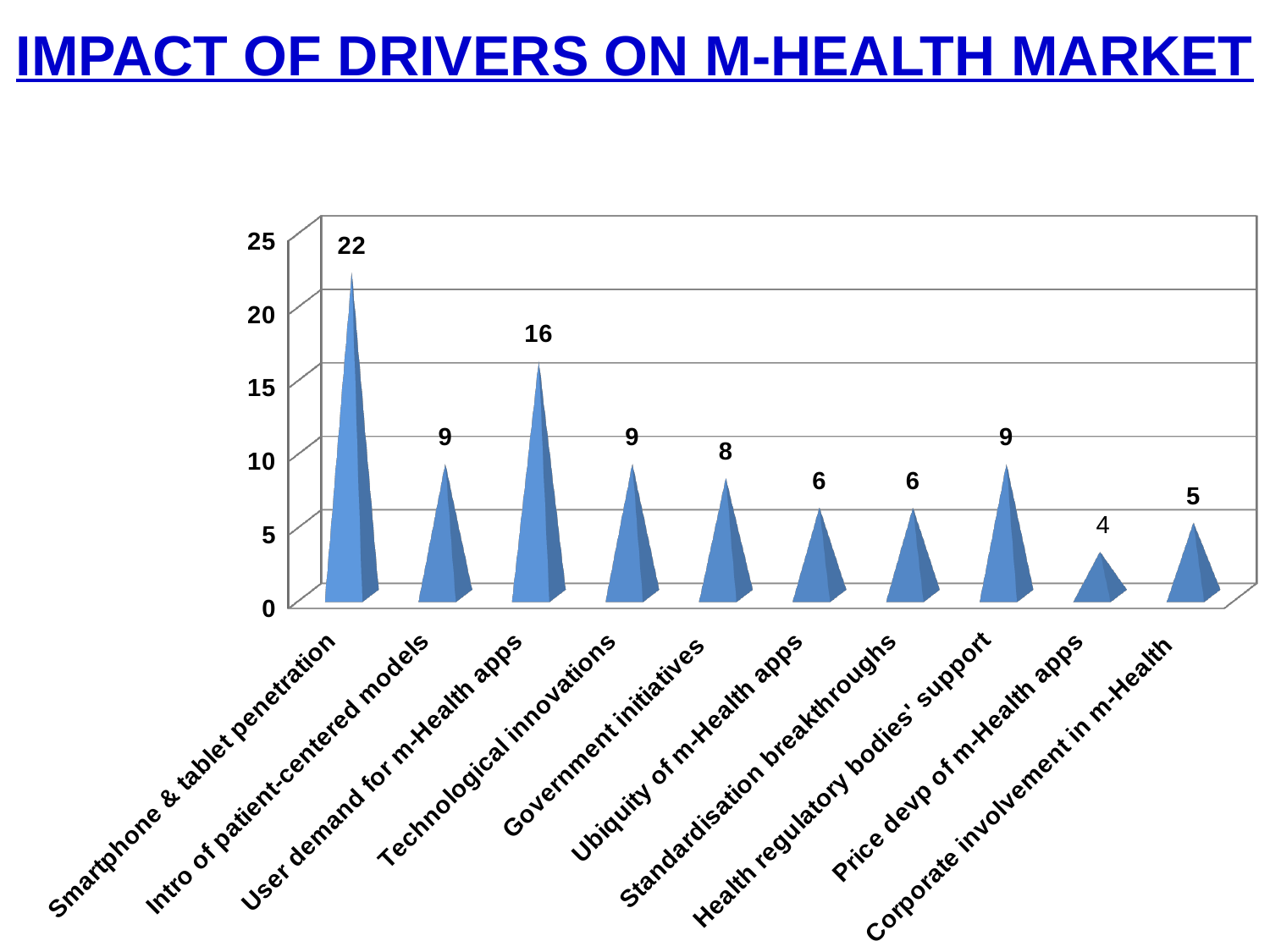
What is the difference between the values for Smartphone & tablet penetration and User demand for m-Health apps? 6 What is the value for Government initiatives? 8 How many categories are shown on the x axis? 10 What kind of chart is shown on the slide? bar chart What is the value for User demand for m-Health apps? 16 Which is larger, the value for Technological innovations or the value for Ubiquity of m-Health apps? Technological innovations Which category has the highest value? Smartphone & tablet penetration What is the value for Price devp of m-Health apps? 4 What is the title of the slide? IMPACT OF DRIVERS ON M-HEALTH MARKET What is the value for Smartphone & tablet penetration? 22 Is the value for Health regulatory bodies' support greater or less than 5? greater Which category has the lowest value? Price devp of m-Health apps